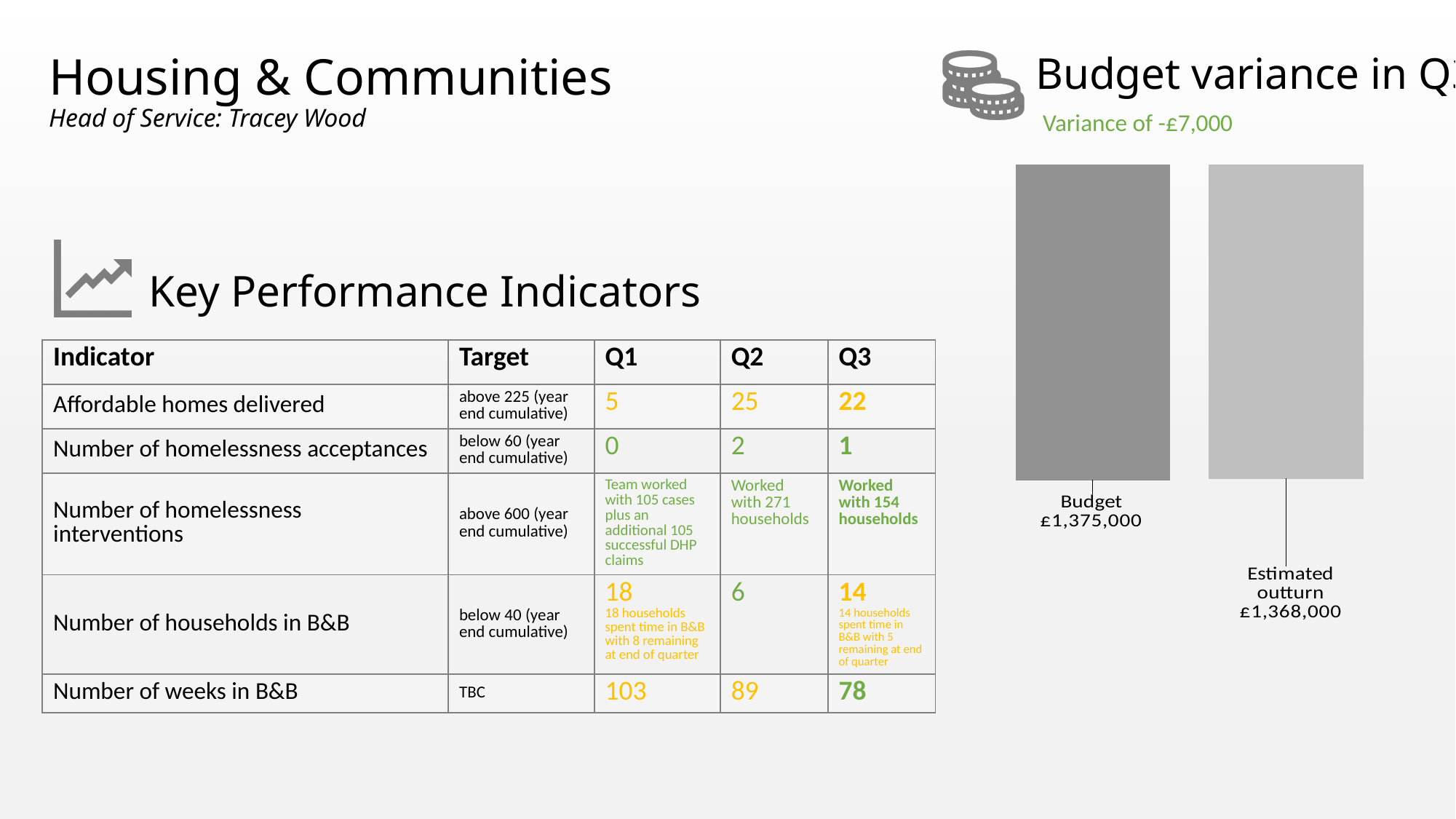
In the budget chart, which category has the lowest value? Estimated outturn In the budget chart, what is the value of the Budget bar? £1,375,000 In the budget chart, what is the value of the Estimated outturn bar? £1,368,000 How many bars are plotted in the budget chart? 2 What type of chart is shown on the right of the slide? bar chart In the budget chart, which bar is higher, Budget or Estimated outturn? Budget What are the two category labels in the budget chart? Budget and Estimated outturn In the budget chart, which category has the highest value? Budget In the budget chart, what is the difference between the Budget and the Estimated outturn? £7,000 What variance is stated above the budget chart? -£7,000